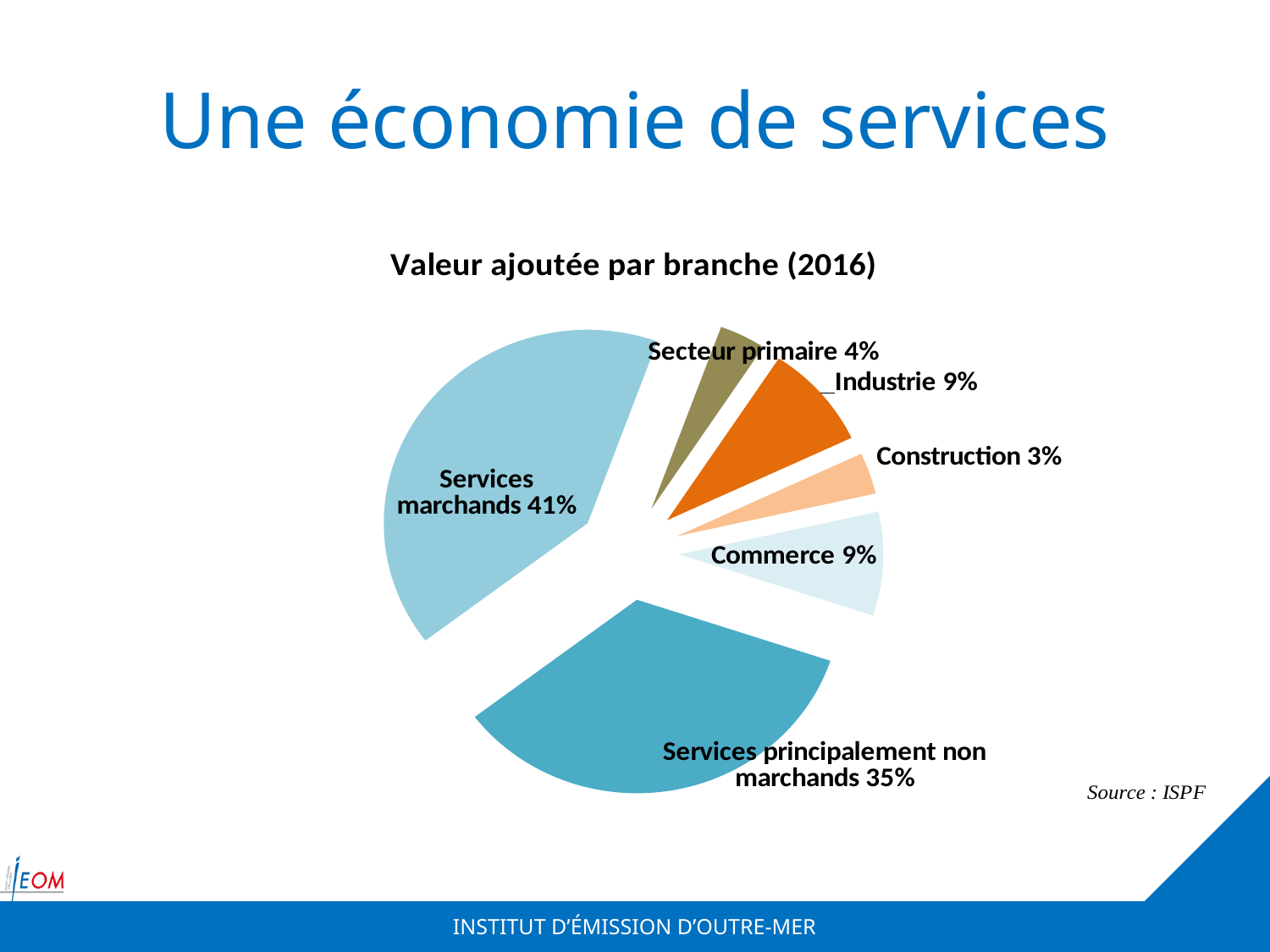
How many slices does the pie chart have? 6 What share of the pie does Services principalement non marchands represent? 35% Which branch has the largest share of the pie? Services marchands What share of the pie does Services marchands represent? 41% What is the value shown for Industrie? 9% What is the title of the chart? Valeur ajoutée par branche (2016) What kind of chart is shown on the slide? Pie chart What is the value shown for Secteur primaire? 4% Which branch has the smallest share of the pie? Construction What is the value shown for Construction? 3% What is the difference between the shares of Services marchands and Services principalement non marchands? 6% Which is larger, the share for Secteur primaire or the share for Construction? Secteur primaire